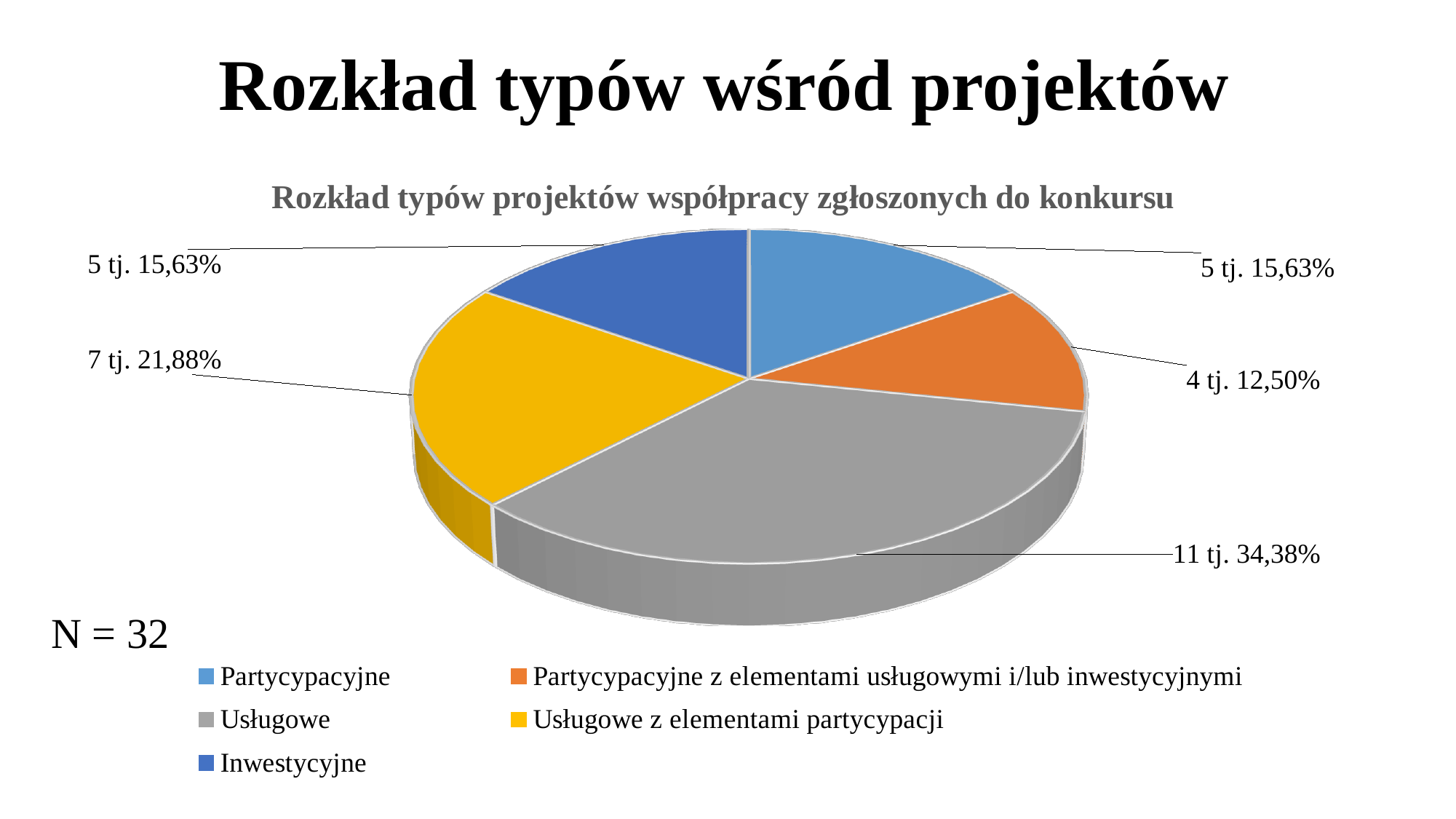
What is the difference in the number of projects between Usługowe and Usługowe z elementami partycypacji? 4 What kind of chart is shown on the slide? pie chart How many projects are in the Usługowe category? 11 What is the title of the chart? Rozkład typów projektów współpracy zgłoszonych do konkursu What share of the pie does the Usługowe slice represent? 34,38% What share of the pie does the Usługowe z elementami partycypacji slice represent? 21,88% How many projects are in the Partycypacyjne z elementami usługowymi i/lub inwestycyjnymi category? 4 Which has more projects, Inwestycyjne or Usługowe z elementami partycypacji? Usługowe z elementami partycypacji How many entries does the legend list? 5 Which category has the smallest slice of the pie? Partycypacyjne z elementami usługowymi i/lub inwestycyjnymi Which category has the largest slice of the pie? Usługowe How many slices does the pie chart have? 5